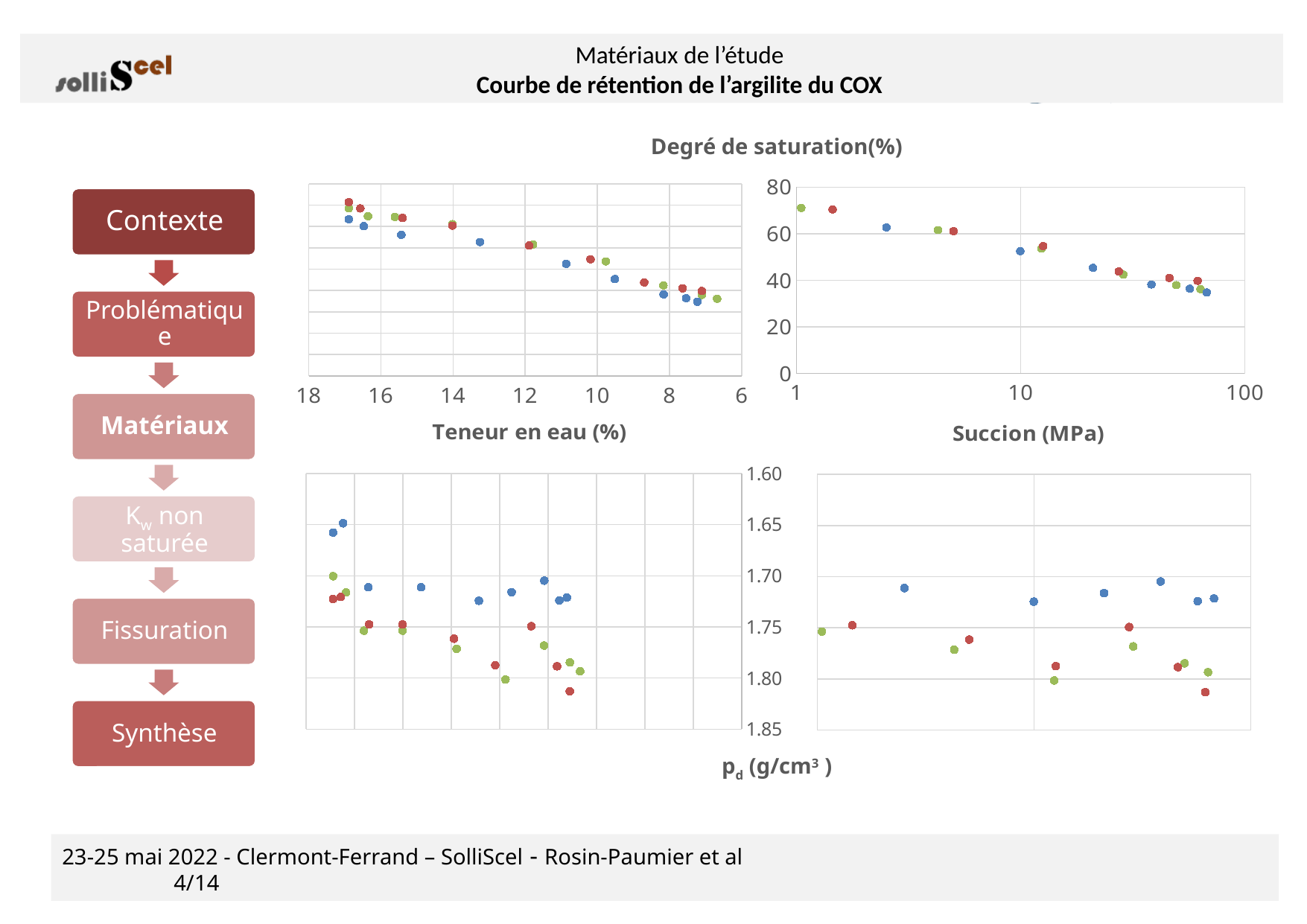
In the bottom-right chart, is the value of the lowest red point greater or less than 1.75? greater What is the x-axis title of the top-right chart? Succion (MPa) In the top-right chart, are the points at the far right (near 100 MPa) greater or less than 60? less How many charts are shown on the slide? 4 What is the x-axis title of the top-left chart? Teneur en eau (%) In the top-right chart, is the degree of saturation of the leftmost point (at a suction of 1 MPa) greater or less than 60? greater What kind of chart is the top-left chart on the slide? scatter chart In the top-left chart, do the plotted values rise or fall moving from left to right along the x axis? fall What kind of chart is the top-right chart with the x axis 'Succion (MPa)'? scatter chart In the top-right chart, do the degree of saturation values rise or fall as suction increases along the x axis? fall